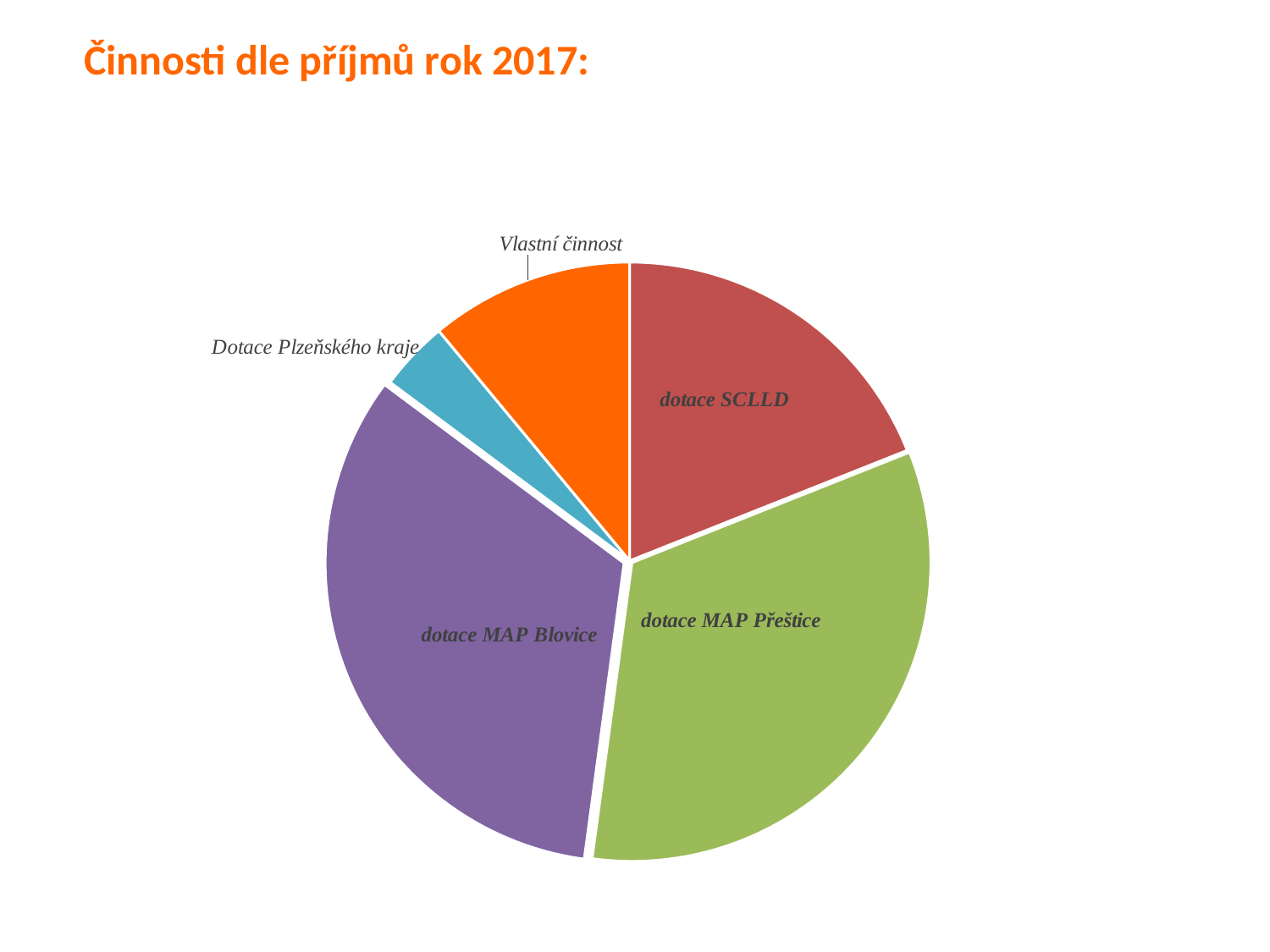
What kind of chart is shown on the slide? pie chart Which category has the smallest slice of the pie chart? Dotace Plzeňského kraje What colour is the dotace MAP Blovice slice? purple How many slices does the pie chart have? 5 Which slice is larger, dotace MAP Blovice or Vlastní činnost? dotace MAP Blovice What is the title of the slide containing the pie chart? Činnosti dle příjmů rok 2017: Which slice is larger, Vlastní činnost or Dotace Plzeňského kraje? Vlastní činnost Which slice is larger, dotace SCLLD or Vlastní činnost? dotace SCLLD